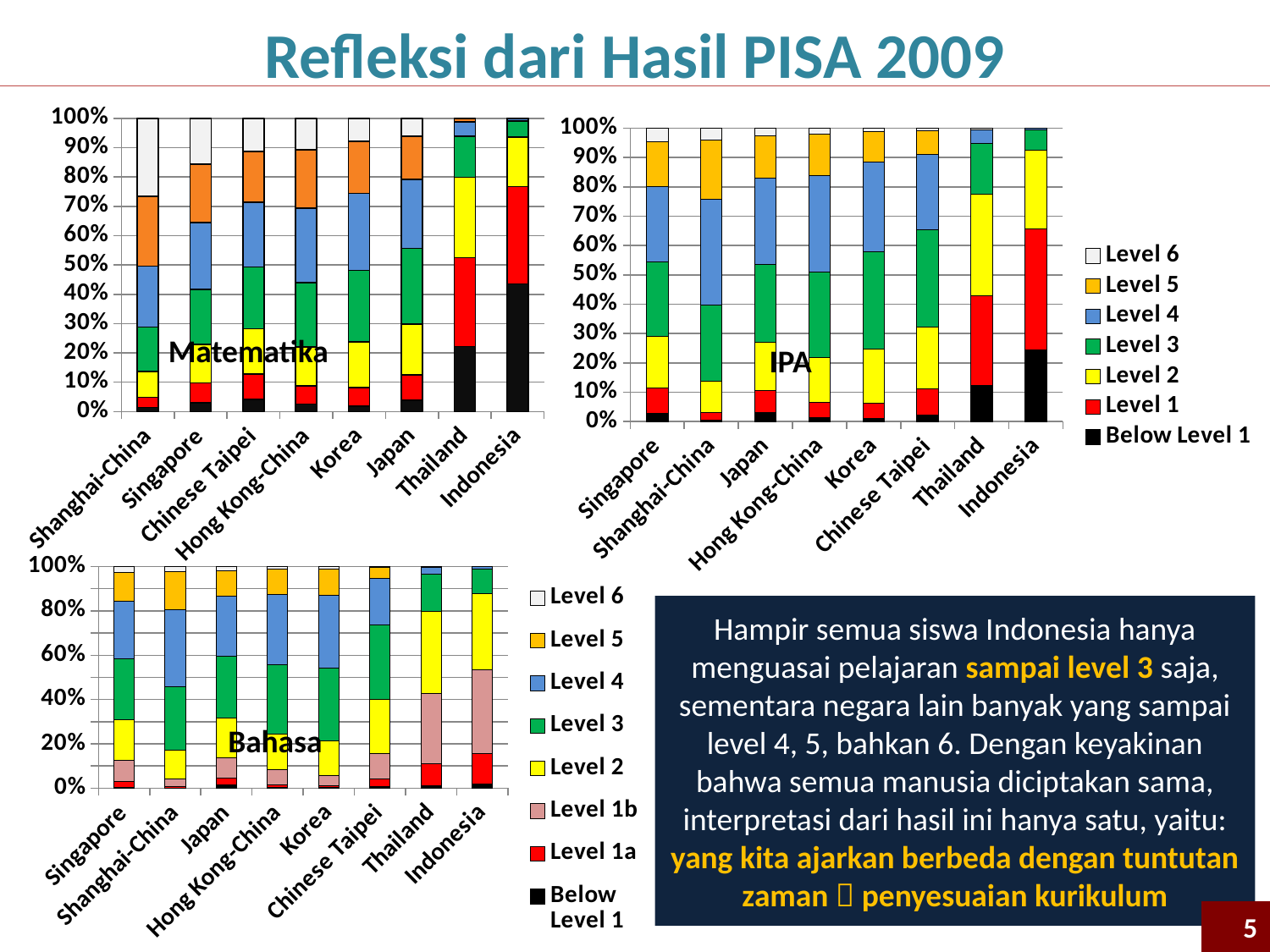
How many countries are shown on the x axis of the Matematika chart? 8 In the Matematika chart, which country has the largest Level 6 segment? Shanghai-China Which country is the first category on the x axis of the IPA chart? Singapore What are the titles of the three charts on the slide? Matematika, IPA, Bahasa How many series does the legend next to the Bahasa chart list? 8 How many series does the legend next to the IPA chart list? 7 In the IPA chart, which is larger, the Below Level 1 segment for Indonesia or for Thailand? Indonesia In the Matematika chart, is the Below Level 1 segment for Indonesia greater or less than 30%? greater What kind of chart is the Matematika chart? stacked bar chart In the IPA chart, is the Below Level 1 segment for Indonesia greater or less than 10%? greater In the Matematika chart, which country has the largest Below Level 1 segment? Indonesia In the Bahasa chart, is the Level 1b segment for Indonesia greater or less than 20%? greater